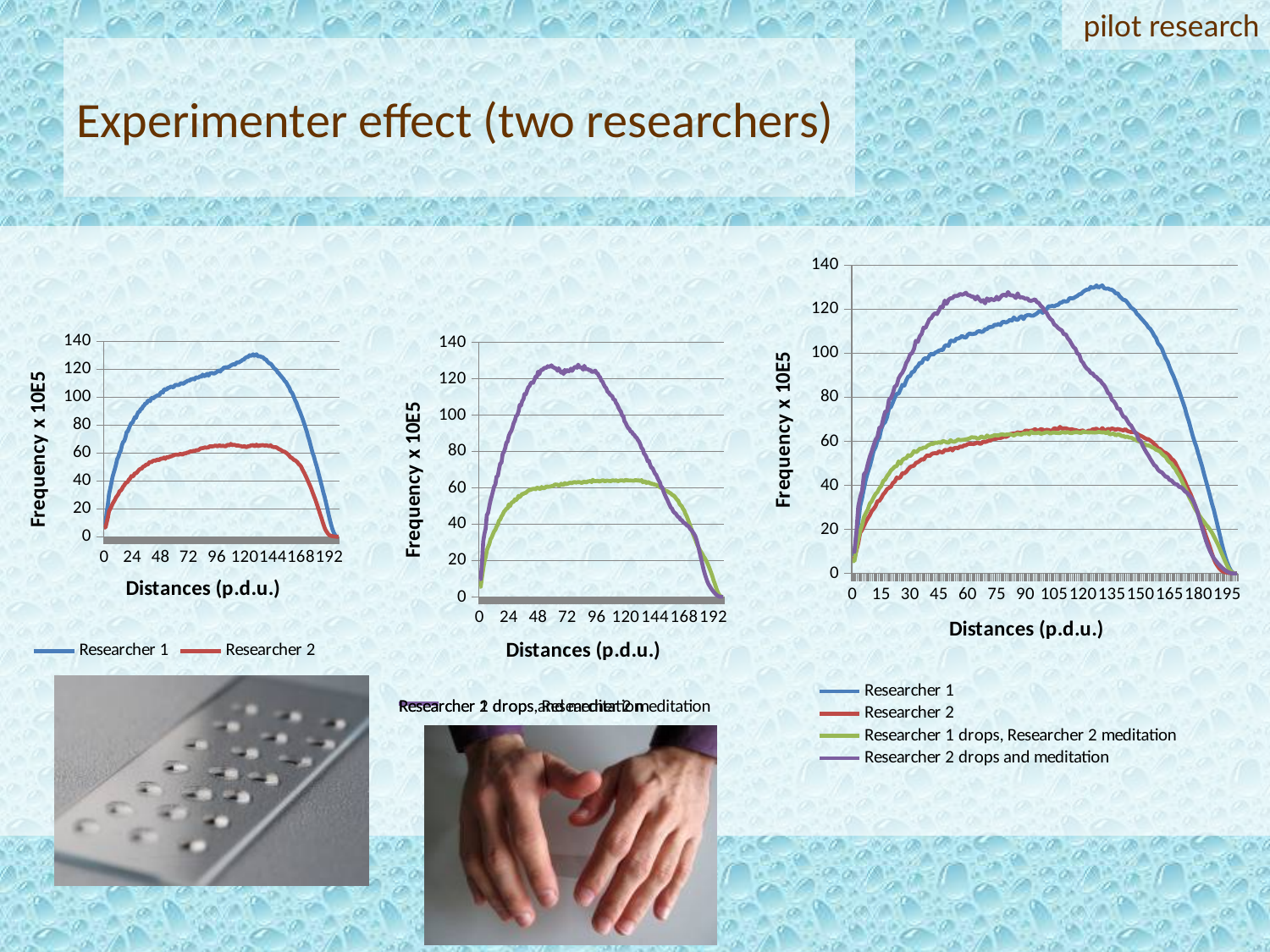
What is the y-axis title of the left chart? Frequency x 10E5 How many series does the legend of the right chart list? 4 What is the x-axis title of the right chart? Distances (p.d.u.) In the left chart, is the peak value for Researcher 2 greater or less than 80? less In the right chart, at a distance of 60, which series has the higher value, Researcher 1 or Researcher 2 drops and meditation? Researcher 2 drops and meditation In the left chart, at a distance of 96, which series has the higher value, Researcher 1 or Researcher 2? Researcher 1 In the right chart, at a distance of 150, which series has the higher value, Researcher 1 or Researcher 2 drops and meditation? Researcher 1 In the right chart, is the value for 'Researcher 2 drops and meditation' at a distance of 60 greater or less than 120? greater In the middle chart, is the peak value of the purple line greater or less than 120? greater What kind of chart is the left chart with the legend 'Researcher 1' and 'Researcher 2'? line chart How many series does the legend of the left chart list? 2